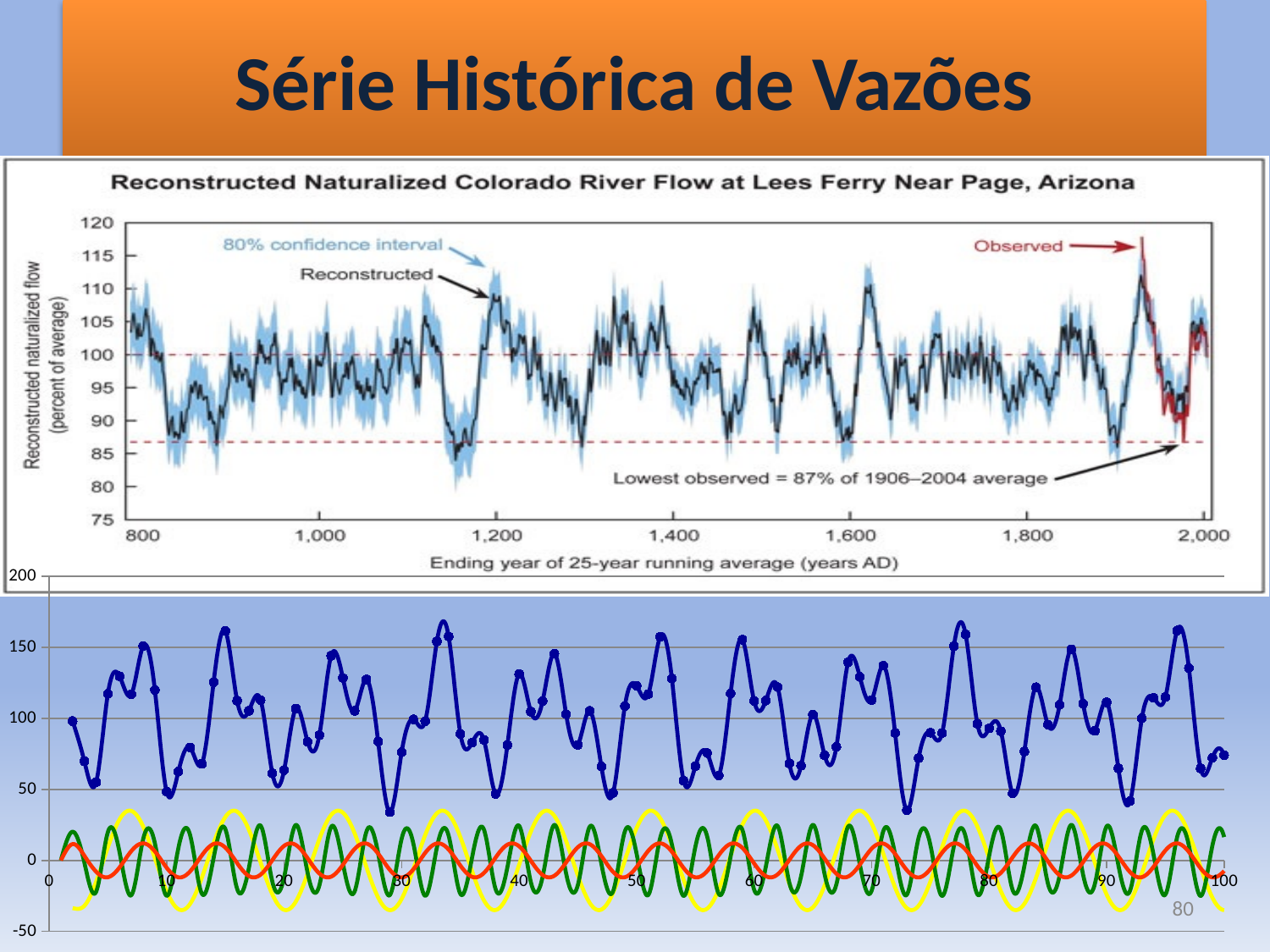
In the top chart, what is the highest value shown on the y axis? 120 In the top chart, what confidence interval is shown by the shaded band? 80% confidence interval In the bottom chart, is the value of the blue line at x = 0 greater or less than 50? greater What kind of chart is the bottom chart? line chart What kind of chart is the top chart, Reconstructed Naturalized Colorado River Flow? line chart In the top chart, what is the lowest observed flow as a percentage of the 1906–2004 average? 87% In the top chart, is the reconstructed flow around year 1,150 greater or less than 90? less How many lines are plotted in the bottom chart? 4 In the top chart, is the reconstructed flow around year 1,200 greater or less than 105? greater In the bottom chart, what is the lowest value shown on the y axis? -50 What is the title of the top chart? Reconstructed Naturalized Colorado River Flow at Lees Ferry Near Page, Arizona In the top chart, what is the label of the x axis? Ending year of 25-year running average (years AD)